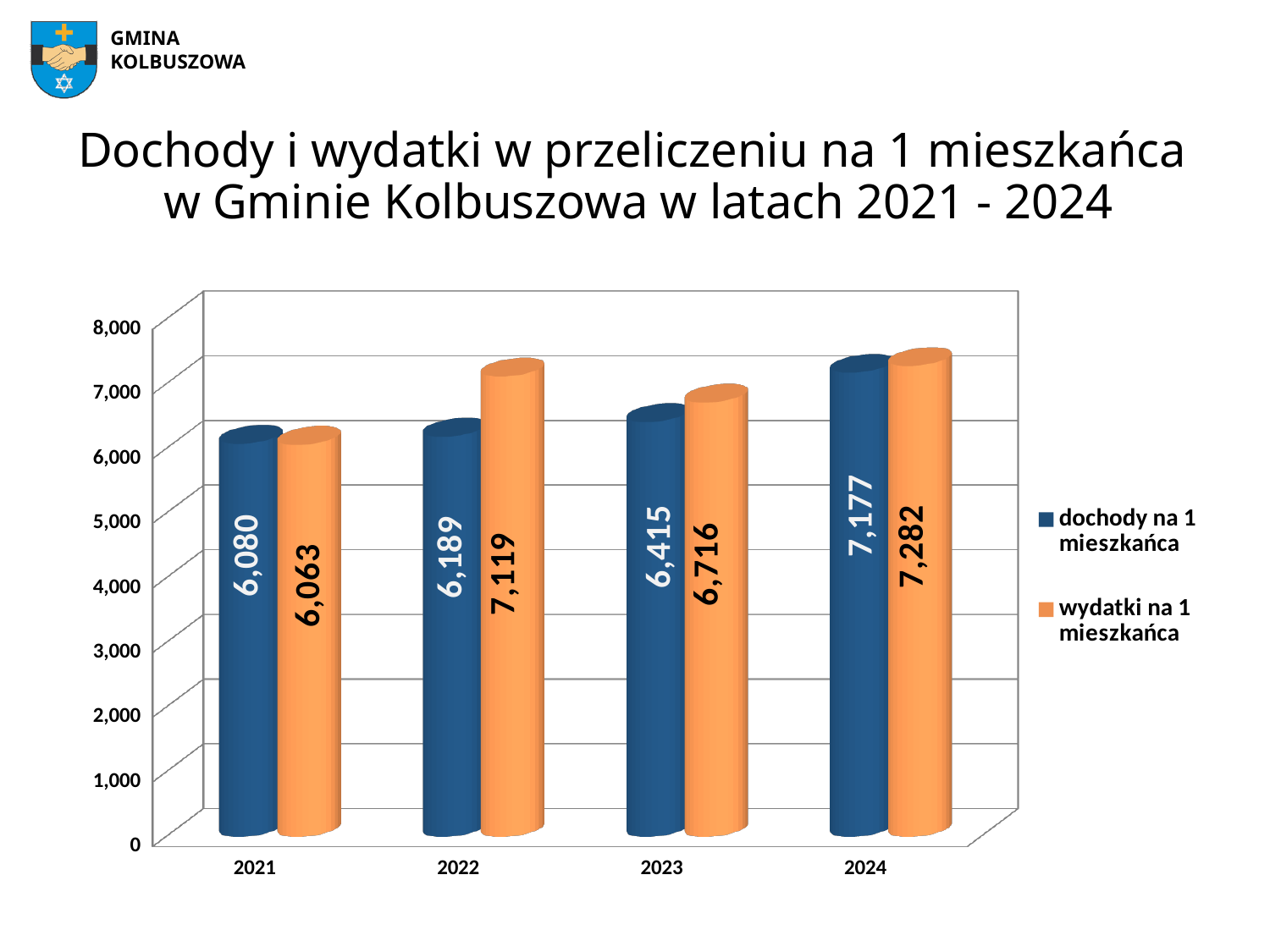
What is the value of 'dochody na 1 mieszkańca' for 2023? 6,415 Do the values for 'dochody na 1 mieszkańca' rise or fall from 2021 to 2024? rise How many years are shown on the x axis? 4 What is the difference between 'wydatki na 1 mieszkańca' and 'dochody na 1 mieszkańca' in 2022? 930 What kind of chart is shown on the slide? bar chart Which year has the highest value for 'dochody na 1 mieszkańca'? 2024 What is the value of 'dochody na 1 mieszkańca' for 2021? 6,080 In 2023, which is larger: 'dochody na 1 mieszkańca' or 'wydatki na 1 mieszkańca'? wydatki na 1 mieszkańca What is the value of 'wydatki na 1 mieszkańca' for 2024? 7,282 How many series does the legend list? 2 Which year has the lowest value for 'wydatki na 1 mieszkańca'? 2021 What is the value of 'wydatki na 1 mieszkańca' for 2022? 7,119